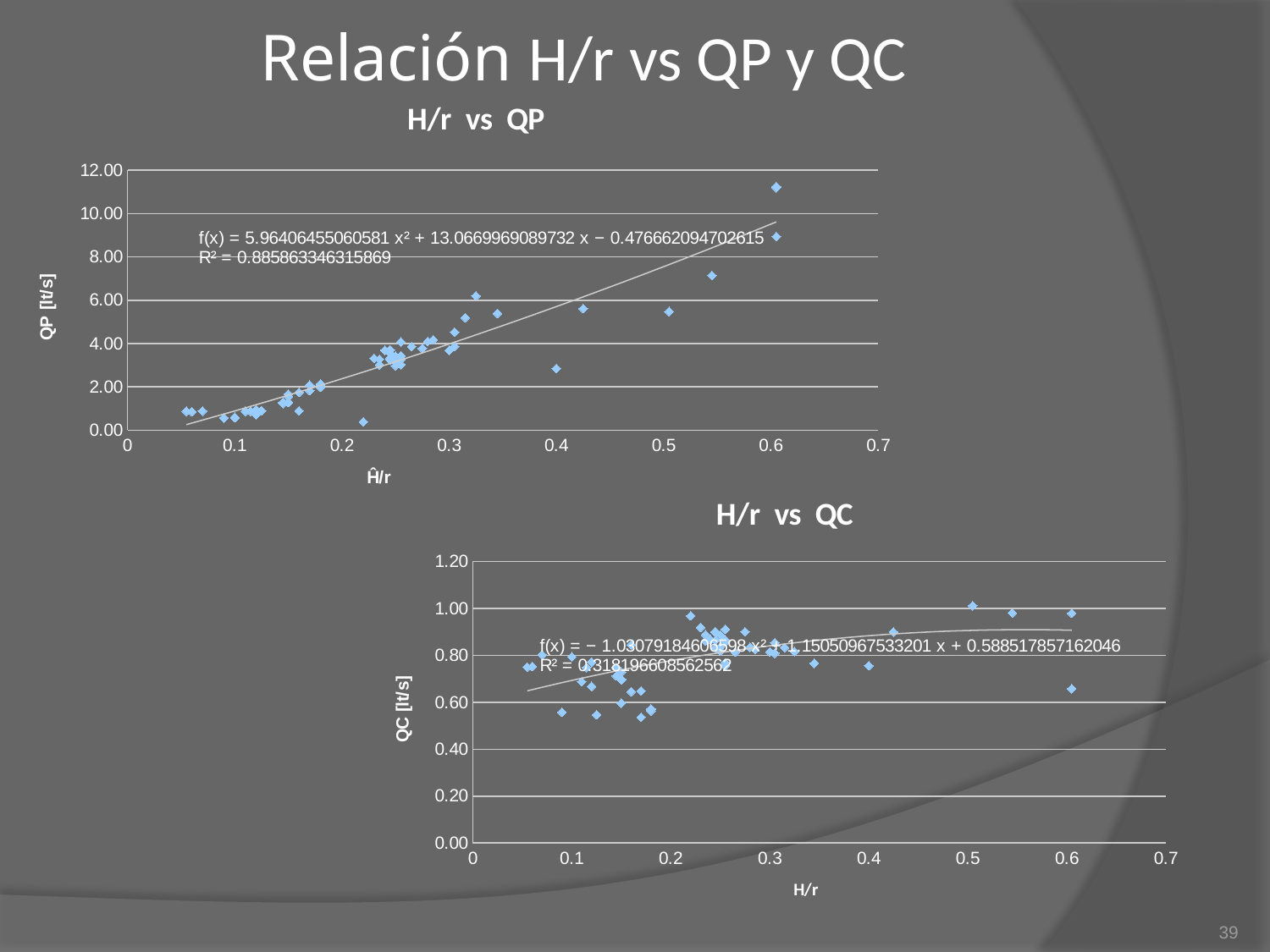
What R² value is shown on the 'H/r vs QP' chart? 0.885863346315869 In the 'H/r vs QP' chart, is the value of the highest point (near H/r = 0.6) greater or less than 10.00? greater In the 'H/r vs QP' chart, do the QP values generally rise or fall as H/r increases? rise What kind of chart is the 'H/r vs QP' chart? scatter chart In the 'H/r vs QC' chart, is the lower point at about H/r = 0.6 greater or less than 0.80? less What kind of chart is the 'H/r vs QC' chart? scatter chart What R² value is shown on the 'H/r vs QC' chart? 0.318196608562562 In the 'H/r vs QP' chart, is the QP value of the point at about H/r = 0.4 greater or less than 4.00? less What is the highest tick value on the y-axis of the 'H/r vs QC' chart? 1.20 What is the highest tick value on the y-axis of the 'H/r vs QP' chart? 12.00 Which chart shows the higher R² value, 'H/r vs QP' or 'H/r vs QC'? H/r vs QP What is the y-axis label of the 'H/r vs QP' chart? QP [lt/s]